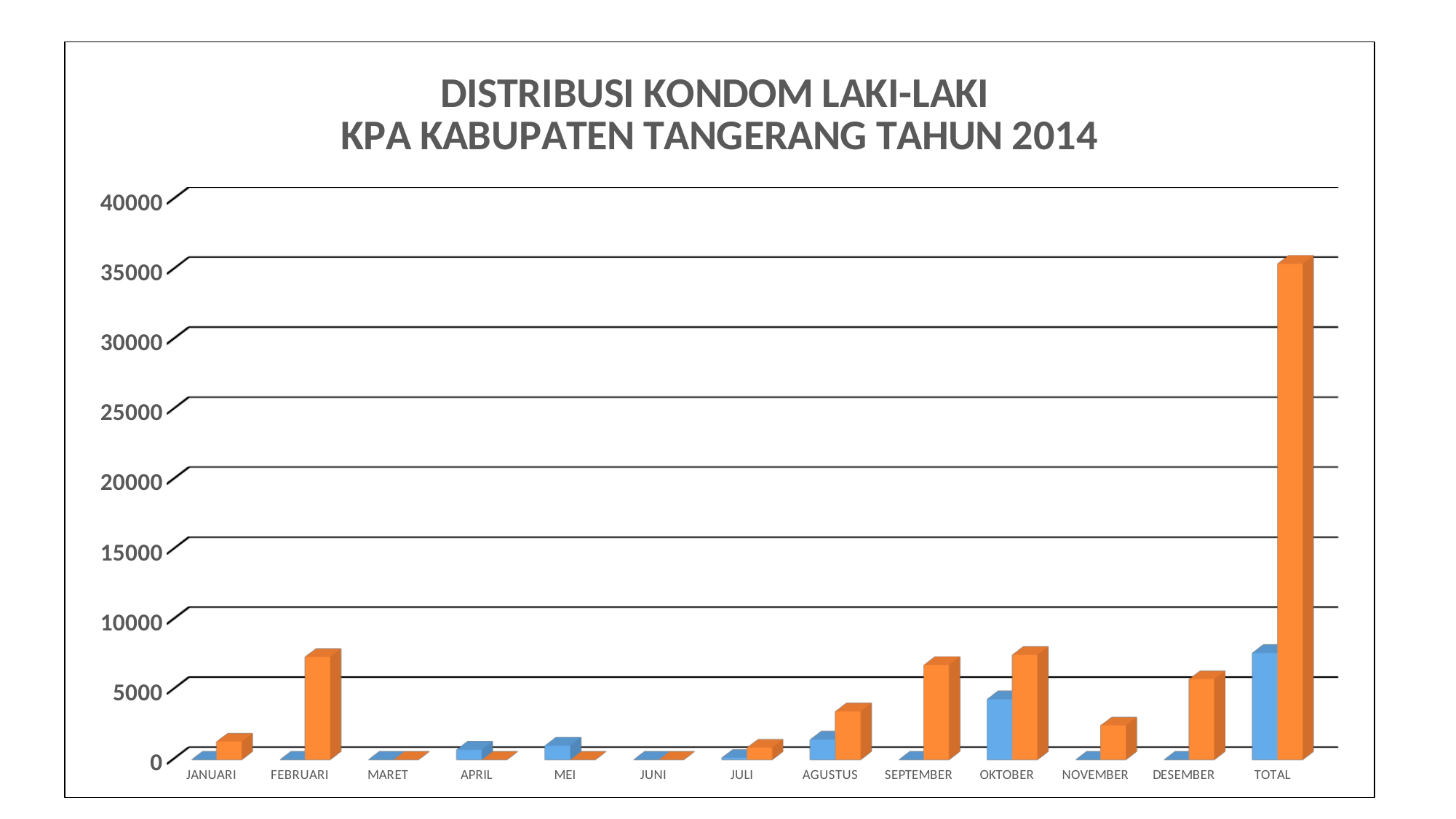
Is the orange bar for NOVEMBER greater or less than 5000? less Is the orange bar for FEBRUARI greater or less than 5000? greater In OKTOBER, which bar is taller, the blue one or the orange one? orange Among the months (excluding TOTAL), which has the tallest blue bar? OKTOBER Which category has the tallest blue bar? TOTAL Is the orange bar for TOTAL greater or less than 30000? greater Which category has the tallest orange bar? TOTAL What is the title of the chart? DISTRIBUSI KONDOM LAKI-LAKI KPA KABUPATEN TANGERANG TAHUN 2014 Which is larger, the orange bar for FEBRUARI or the orange bar for NOVEMBER? FEBRUARI How many categories are shown on the x axis of the chart? 13 What kind of chart is shown on the slide? bar chart